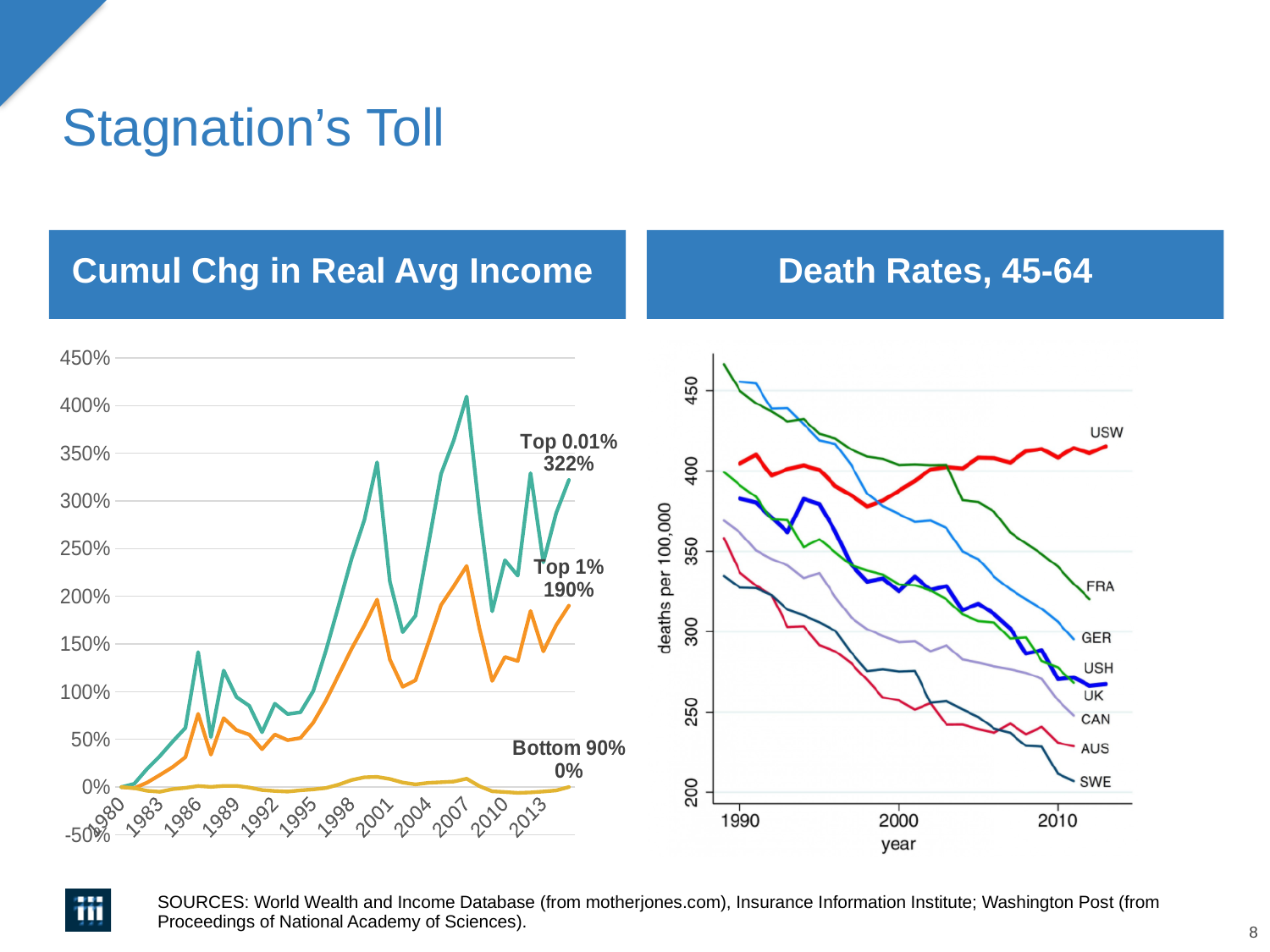
How many country series are labeled in the 'Death Rates, 45-64' chart? 8 In the 'Cumul Chg in Real Avg Income' chart, what is the labeled value for the Top 0.01% series? 322% In the 'Cumul Chg in Real Avg Income' chart, what is the labeled value for the Top 1% series? 190% In the 'Death Rates, 45-64' chart, does the USW series rise or fall over the period shown? Rises In the 'Cumul Chg in Real Avg Income' chart, what is the labeled value for the Bottom 90% series? 0% What kind of chart is the 'Death Rates, 45-64' chart? Line chart In the 'Cumul Chg in Real Avg Income' chart, what is the difference between the labeled values for Top 0.01% and Top 1%? 132% How many series are plotted in the 'Cumul Chg in Real Avg Income' chart? 3 In the 'Death Rates, 45-64' chart, is the value for SWE at the end of the period greater or less than 250? less In the 'Cumul Chg in Real Avg Income' chart, which series has the lowest labeled value? Bottom 90% In the 'Cumul Chg in Real Avg Income' chart, which series has the highest labeled value? Top 0.01% In the 'Death Rates, 45-64' chart, which series has the highest death rate at the end of the period? USW